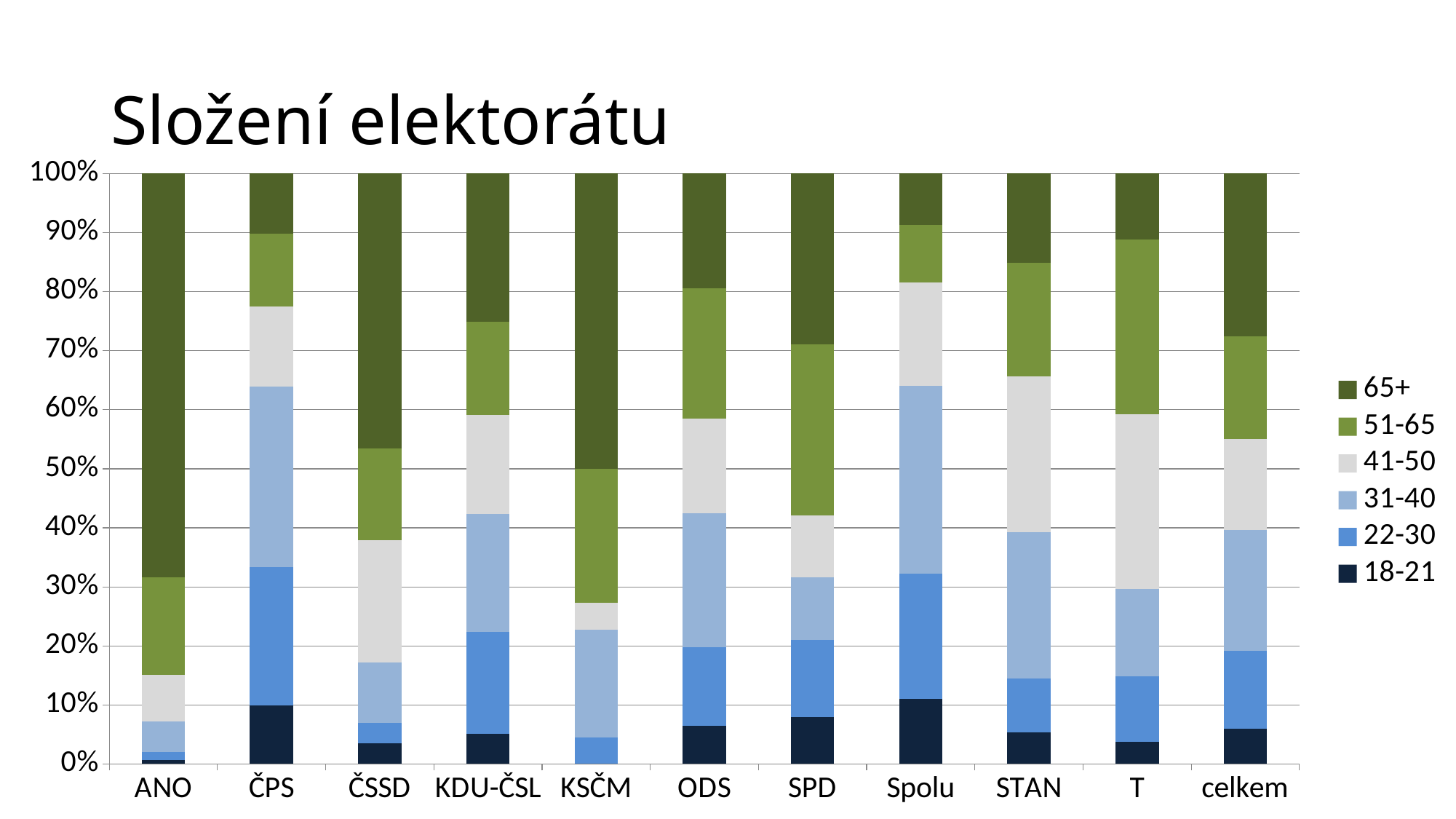
How many categories are shown on the x axis? 11 What kind of chart is shown on the slide? stacked bar chart What is the title of the chart? Složení elektorátu Which legend entry is shown in the darkest green colour? 65+ How many series does the legend list? 6 Is the combined share of 18-21 and 22-30 for ČPS greater or less than 20%? greater Which has the larger 18-21 share, ANO or ČPS? ČPS Is the 18-21 share for ANO greater or less than 10%? less Which category has the largest 65+ share? ANO Which has the larger 65+ share, ANO or ČPS? ANO Which has the larger 31-40 share, ANO or ČPS? ČPS Is the 18-21 share for ČSSD greater or less than 10%? less